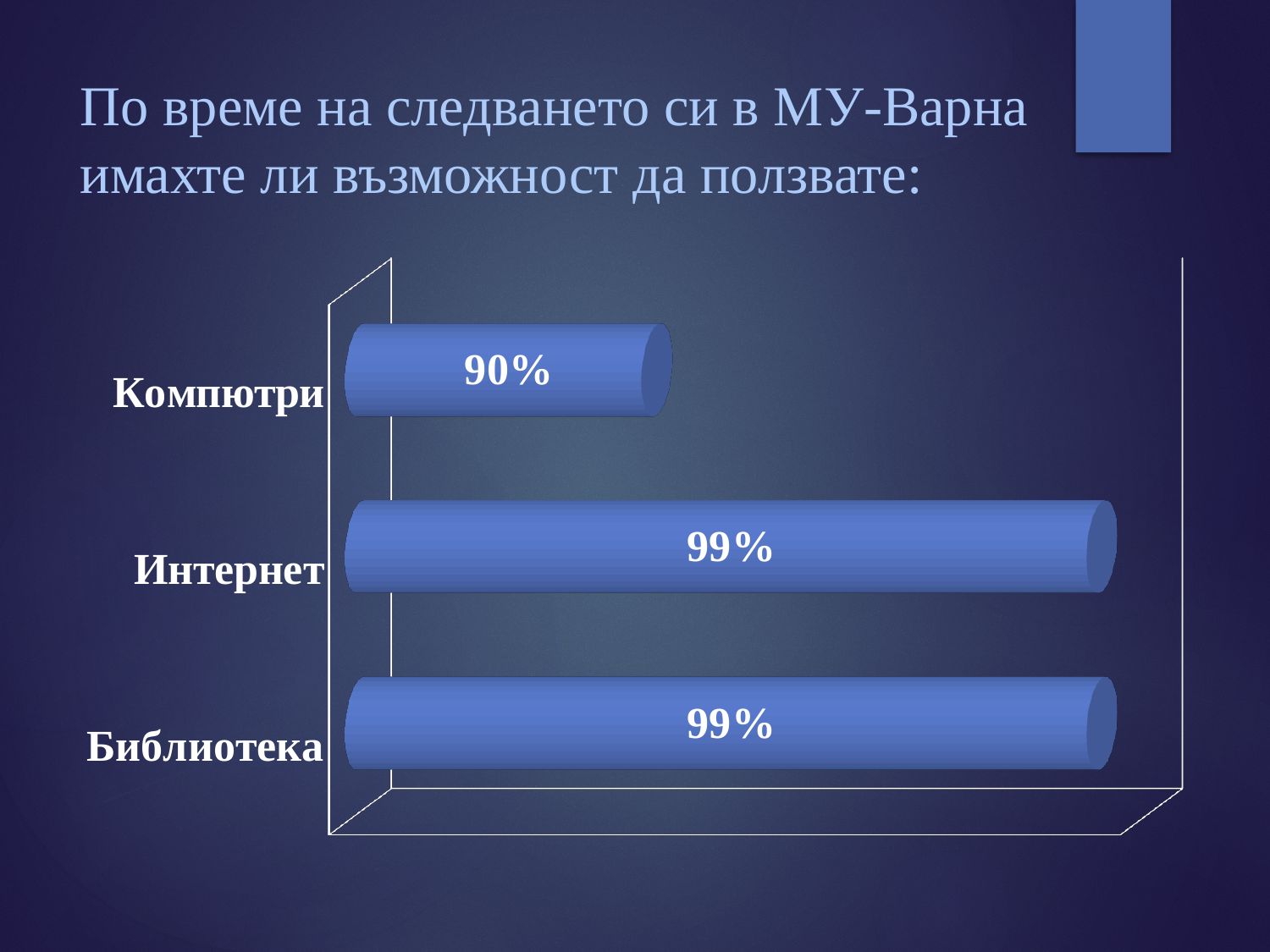
Do the values for Интернет and Библиотека have the same value? Yes How many categories are shown in the chart? 3 What is the value for Компютри? 90% What kind of chart is shown on the slide? Bar chart What is the difference between the values for Интернет and Компютри? 9% What is the value for Библиотека? 99% What is the title of the slide? По време на следването си в МУ-Варна имахте ли възможност да ползвате: Which is larger, the value for Компютри or the value for Библиотека? Библиотека What is the value for Интернет? 99% What is the difference between the values for Библиотека and Компютри? 9% Which category has the lowest value? Компютри Which is larger, the value for Интернет or the value for Компютри? Интернет